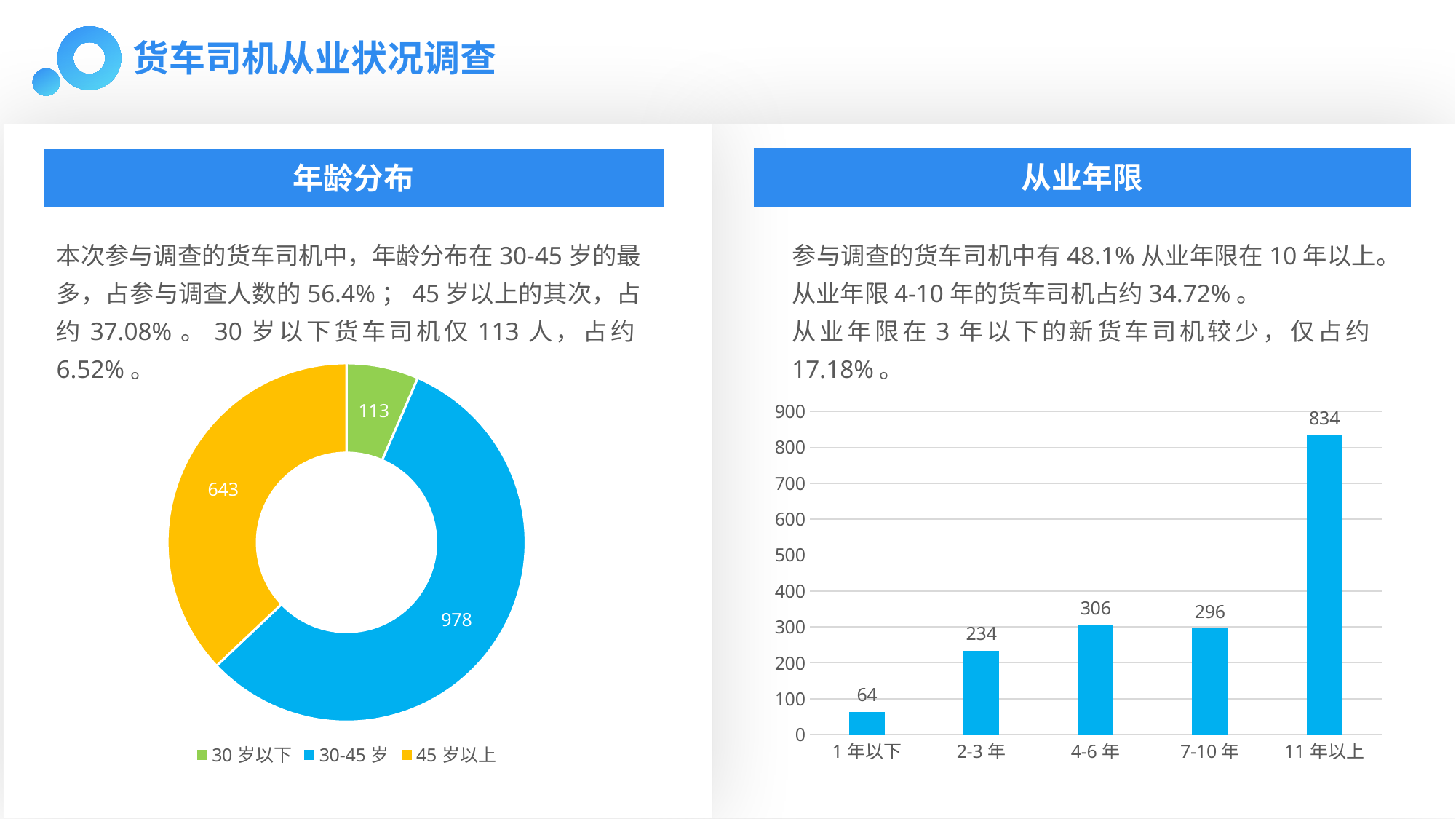
In the 从业年限 chart, which category has the highest value? 11 年以上 In the 年龄分布 chart, what is the difference between the values for 30-45 岁 and 45 岁以上? 335 In the 从业年限 chart, what is the value for 2-3 年? 234 What kind of chart is the 年龄分布 chart? Donut (pie) chart In the 年龄分布 chart, what is the value for 30-45 岁? 978 In the 从业年限 chart, which is larger, 4-6 年 or 7-10 年? 4-6 年 What kind of chart is the 从业年限 chart? Bar chart In the 年龄分布 chart, what share of the total does 30 岁以下 represent? 6.52% In the 年龄分布 chart, which age group has the smallest value? 30 岁以下 How many categories are shown in the 从业年限 chart? 5 In the 年龄分布 chart, what is the value for 45 岁以上? 643 In the 从业年限 chart, what is the difference between 11 年以上 and 1 年以下? 770